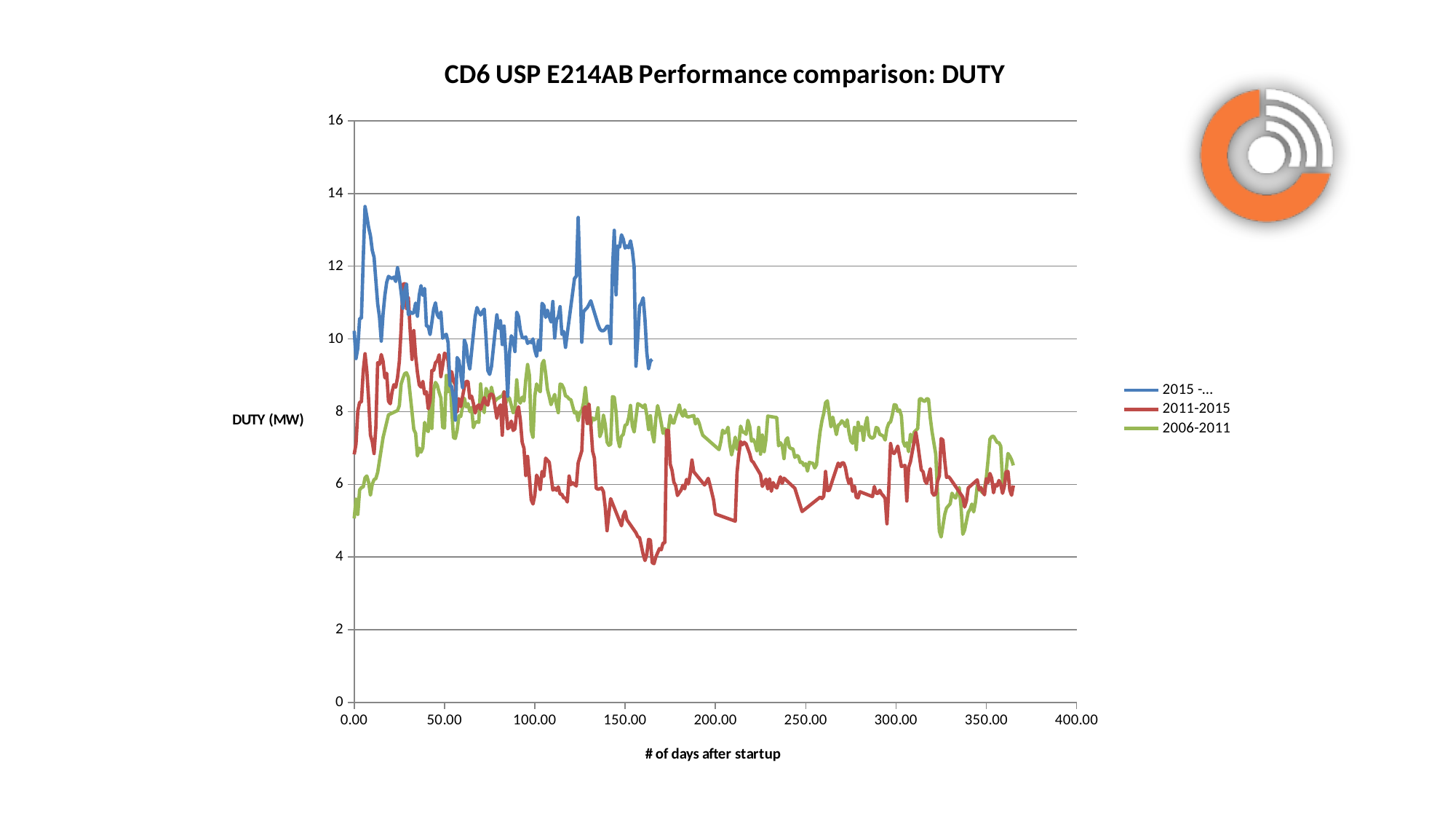
Does the 2011-2015 series generally rise or fall as the number of days after startup increases? fall What kind of chart is shown on the slide? line chart Which series reaches the highest value on the chart? 2015 -... How many series does the legend list? 3 What is the title of the chart? CD6 USP E214AB Performance comparison: DUTY What is the label of the vertical axis? DUTY (MW) Is the value of the 2006-2011 series at day 0 greater or less than 6? less Is the peak value of the 2015 -... series greater or less than 12? greater At around day 100, which series has the larger value, 2015 -... or 2011-2015? 2015 -... Is the value of the 2011-2015 series at around day 160 greater or less than 6? less Which series reaches the lowest value on the chart? 2011-2015 Which series ends at the smallest number of days after startup? 2015 -...